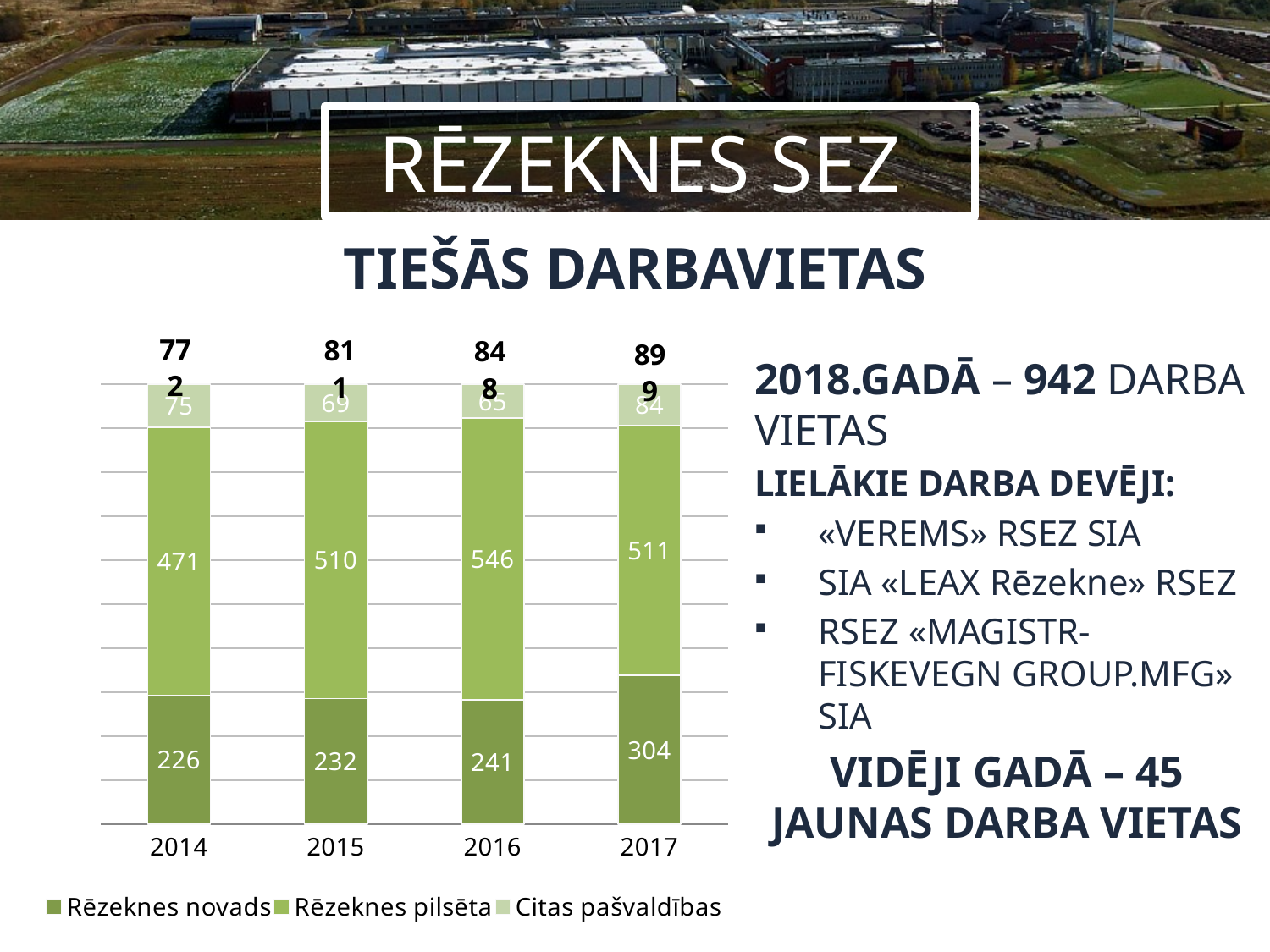
In which year is the Rēzeknes pilsēta value lowest? 2014 What is the value for Rēzeknes pilsēta in 2016? 546 How many series does the legend list? 3 What is the difference between the Rēzeknes pilsēta values in 2015 and 2014? 39 Does the Rēzeknes novads value rise or fall from 2014 to 2017? rise Which is larger, the Rēzeknes novads value in 2016 or in 2015? 2016 What is the value for Rēzeknes novads in 2017? 304 What kind of chart is shown on the slide? stacked bar chart What is the total of the stacked bar for 2014? 772 What is the value for Citas pašvaldības in 2014? 75 How many years are shown on the x axis of the chart? 4 In which year is the Rēzeknes novads value highest? 2017